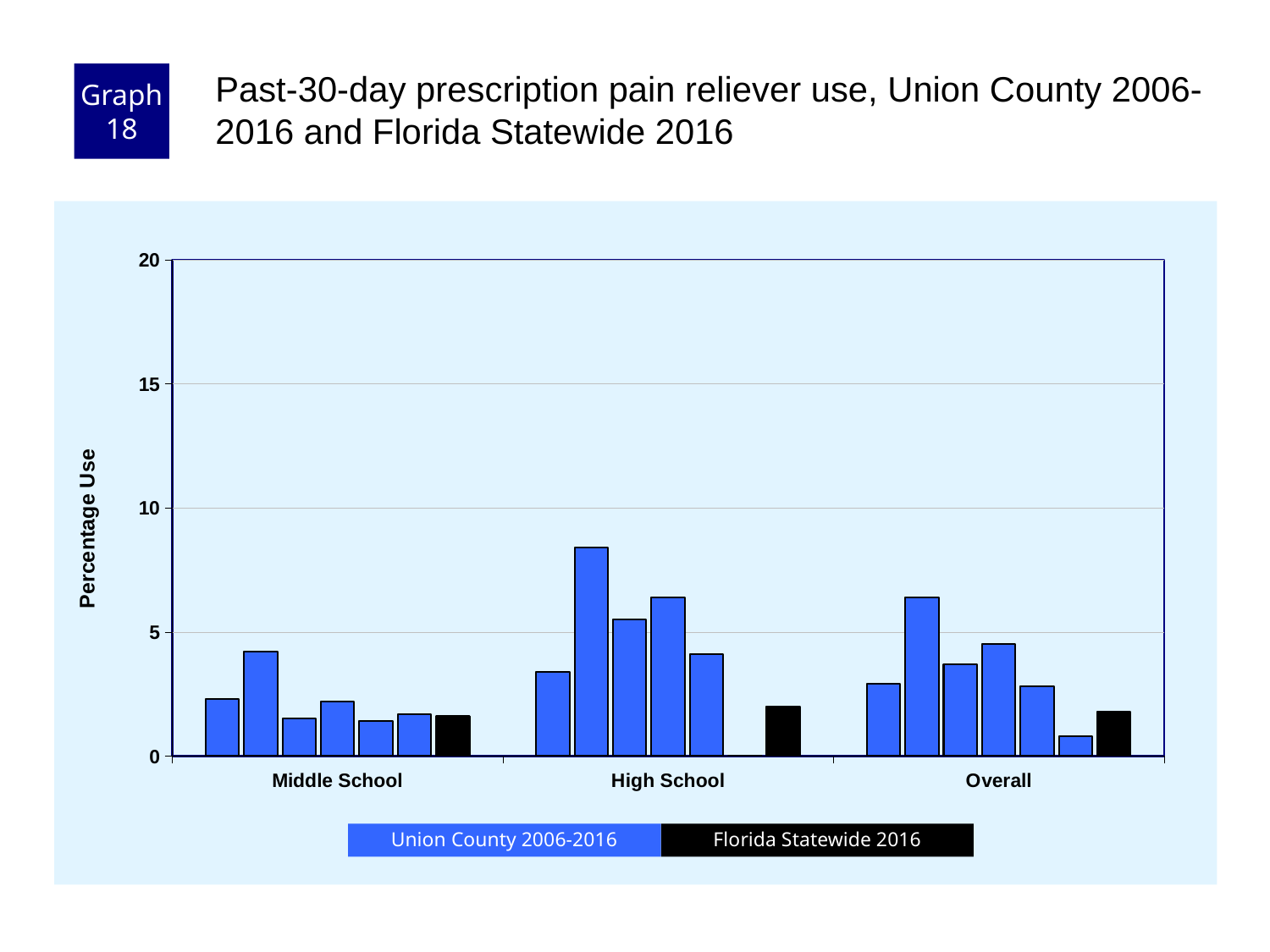
What kind of chart is shown on the slide? bar chart What is the highest value shown on the y axis? 20 Is the Florida Statewide 2016 value for Middle School greater or less than 5? less How many series does the legend list? 2 How many school-level categories are shown on the x axis? 3 Which is larger: the tallest Union County 2006-2016 bar for High School or the tallest Union County 2006-2016 bar for Middle School? High School Is the tallest Union County 2006-2016 bar for High School greater or less than 10? less What is the title of the y axis? Percentage Use Is the tallest Union County 2006-2016 bar for High School greater or less than 5? greater Which category contains the tallest bar in the chart? High School